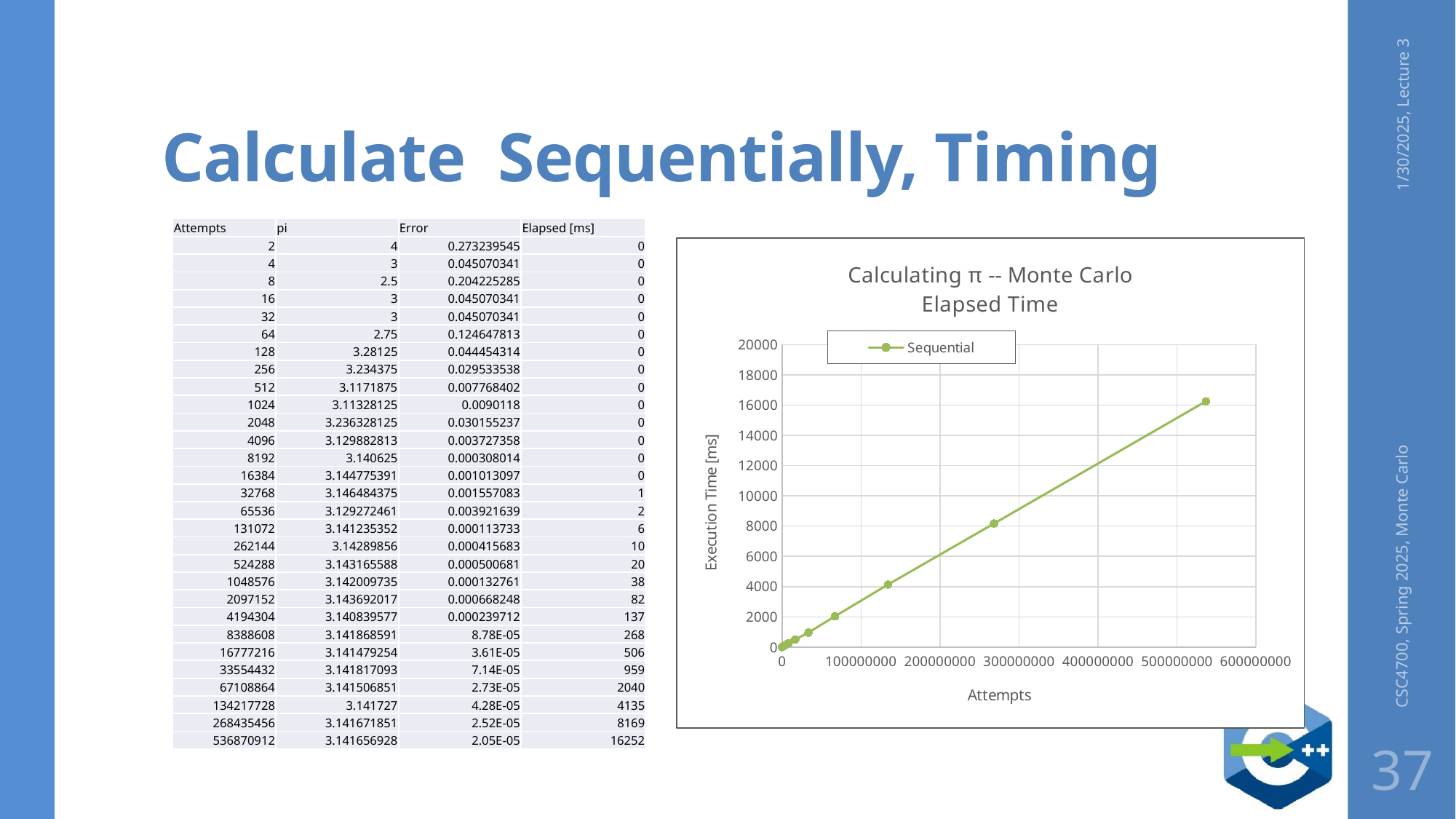
Is the execution time for the data point between 100000000 and 200000000 attempts greater or less than 6000? less How many series does the chart legend list? 1 Is the execution time for the data point near 300000000 attempts greater or less than 10000? less Is the execution time for the rightmost data point (the largest number of attempts) greater or less than 18000? less Which has the higher execution time: the data point near 300000000 attempts or the rightmost data point? the rightmost data point Does the execution time rise or fall as the number of attempts increases along the x axis? rise What kind of chart is shown on the slide? line chart What is the title of the chart? Calculating π -- Monte Carlo Elapsed Time What is the name of the series shown in the chart legend? Sequential